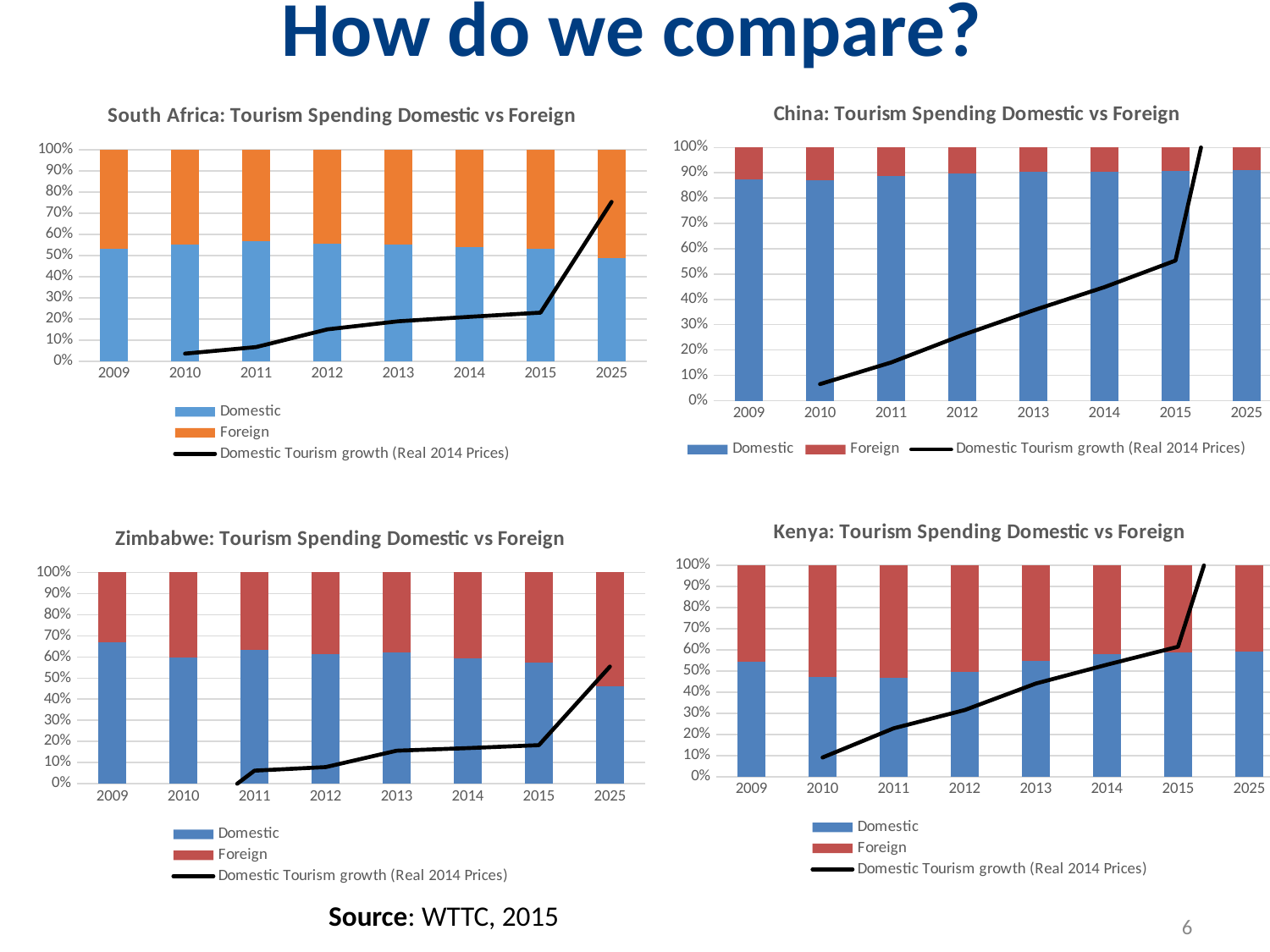
What is the title of the top-right chart? China: Tourism Spending Domestic vs Foreign On the Zimbabwe chart, which year has the highest Domestic share? 2009 On the South Africa chart, what colour represents the Foreign series? orange On the China chart, how many series does the legend list? 3 On the Zimbabwe chart, which year has the larger Domestic share, 2009 or 2025? 2009 On the China chart, does the Domestic Tourism growth (Real 2014 Prices) line rise or fall from 2010 to 2025? rise On the Zimbabwe chart, is the Domestic share for 2025 greater or less than 50%? less On the Kenya chart, is the Domestic share for 2011 greater or less than 50%? less On the China chart, is the Domestic share for 2009 greater or less than 80%? greater On the South Africa chart, how many years are shown on the x axis? 8 On the Zimbabwe chart, what kind of chart is used to show the Domestic and Foreign series? stacked bar chart